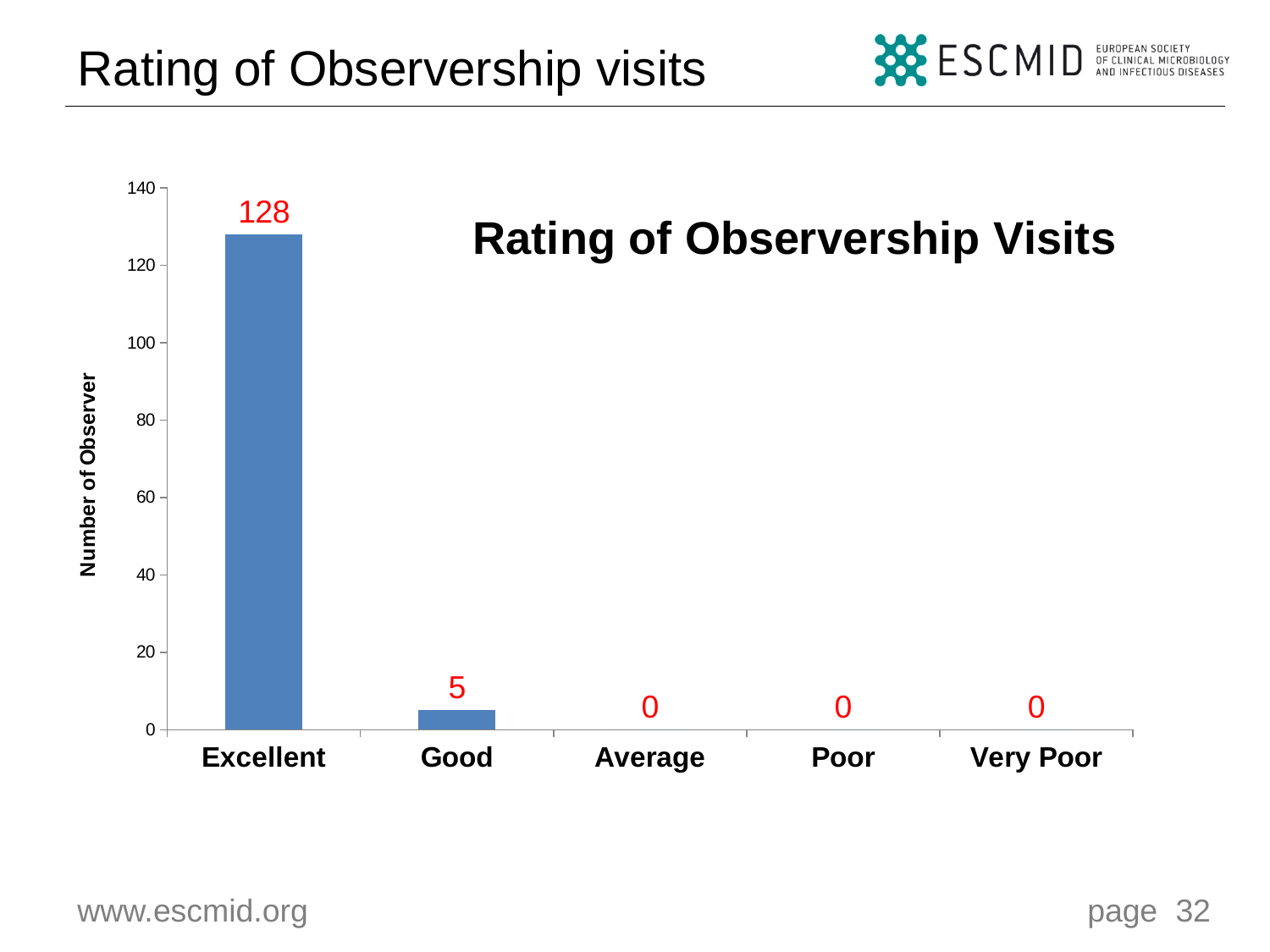
What is the number of observers who rated the observership visits as Good? 5 Is the value for Excellent greater or less than 120? greater What is the number of observers who rated the observership visits as Excellent? 128 What is the value shown for the Average rating? 0 Which has more observers, Good or Poor? Good Do the values rise or fall moving from Excellent to Very Poor along the x axis? Fall How many rating categories are shown on the x axis? 5 What is the title of the chart? Rating of Observership Visits What is the label of the vertical axis? Number of Observer Which rating category has the highest number of observers? Excellent What kind of chart is shown on the slide? Bar chart What is the difference between the number of observers rating Excellent and those rating Good? 123